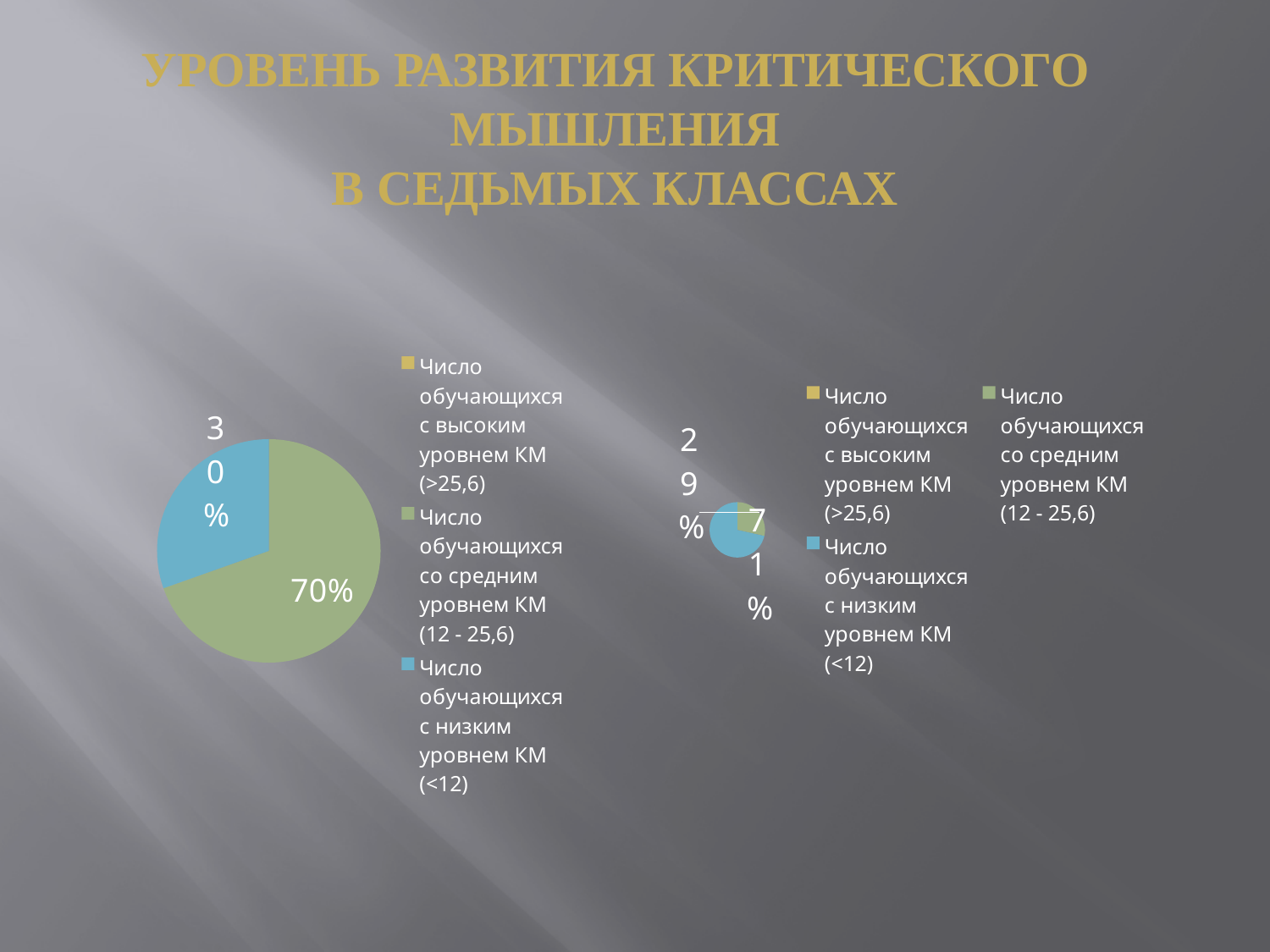
On the left pie chart, which category has the largest slice? Число обучающихся со средним уровнем КМ (12 - 25,6) How many entries does the legend of the left pie chart list? 3 On the left pie chart, which is larger: the share of students with a medium level or the share with a low level? Medium level How many entries does the legend of the right pie chart list? 3 On the left pie chart, what is the difference in percentage points between the medium-level share and the low-level share? 40 percentage points On the right pie chart, what is the difference in percentage points between the medium-level share and the low-level share? 42 percentage points What kind of chart is the left chart on the slide? Pie chart On the left pie chart, what share is shown for the number of students with a medium level of critical thinking (12 - 25,6)? 70% On the right pie chart, which category has the largest slice? Число обучающихся с низким уровнем КМ (<12) On the right pie chart, what share is shown for the number of students with a low level of critical thinking (<12)? 71% On the right pie chart, what share is shown for the number of students with a medium level of critical thinking (12 - 25,6)? 29%